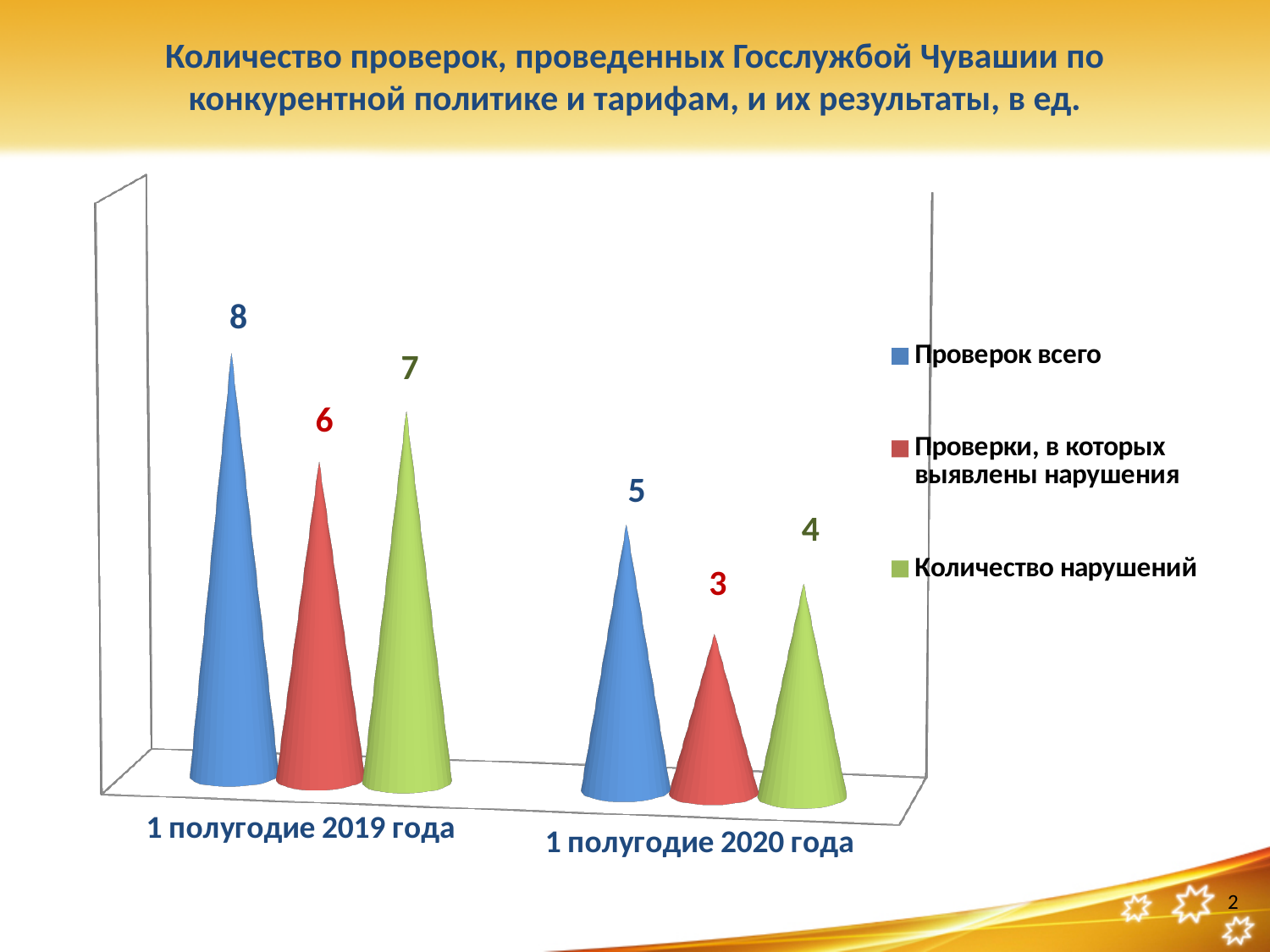
Do the values for "Проверки, в которых выявлены нарушения" rise or fall from 1 полугодие 2019 года to 1 полугодие 2020 года? Fall Which category has the highest value for "Проверок всего"? 1 полугодие 2019 года What is the difference between "Проверок всего" in 1 полугодие 2019 года and 1 полугодие 2020 года? 3 What is the value of "Проверки, в которых выявлены нарушения" for "1 полугодие 2020 года"? 3 What is the value of "Количество нарушений" for "1 полугодие 2020 года"? 4 What is the value of "Проверок всего" for "1 полугодие 2019 года"? 8 What is the value of "Количество нарушений" for "1 полугодие 2019 года"? 7 How many series does the legend list? 3 Which is larger: "Количество нарушений" for 1 полугодие 2019 года or for 1 полугодие 2020 года? 1 полугодие 2019 года What kind of chart is shown on the slide? Bar chart How many categories are shown on the x axis? 2 Which series has the lowest value for "1 полугодие 2020 года"? Проверки, в которых выявлены нарушения